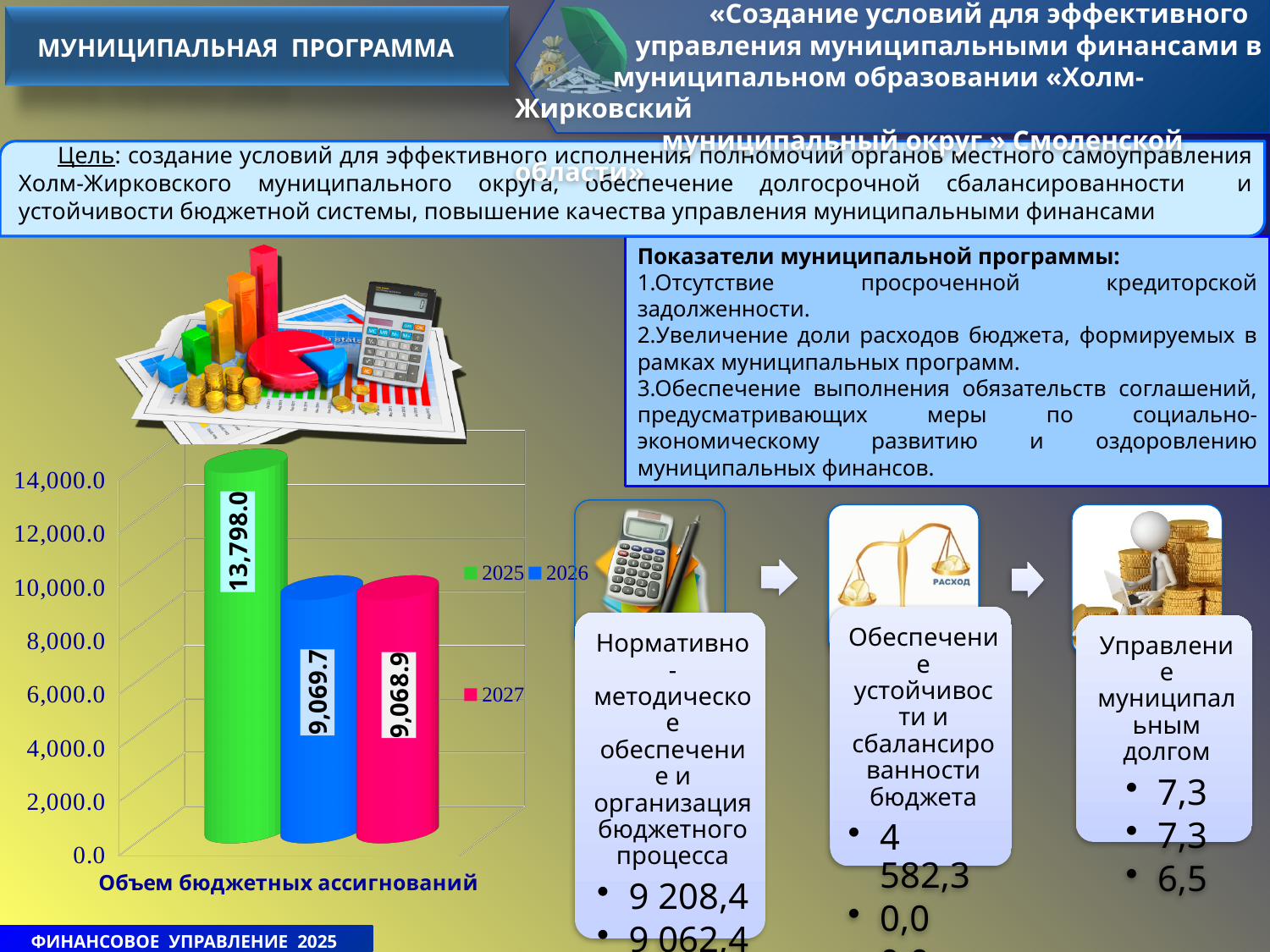
What kind of chart is shown on the slide? Bar chart Is the value for 2026 greater or less than 10,000.0? less Which series has the highest value in the chart? 2025 What is the difference between the 2025 value and the 2026 value? 4,728.3 What is the difference between the 2026 value and the 2027 value? 0.8 Which is larger, the value for 2025 or the value for 2027? 2025 What is the value for the 2025 series in the chart? 13,798.0 What is the value for the 2027 series in the chart? 9,068.9 Is the value for 2025 greater or less than 12,000.0? greater What is the category label shown below the chart? Объем бюджетных ассигнований How many series does the chart legend list? 3 What is the value for the 2026 series in the chart? 9,069.7